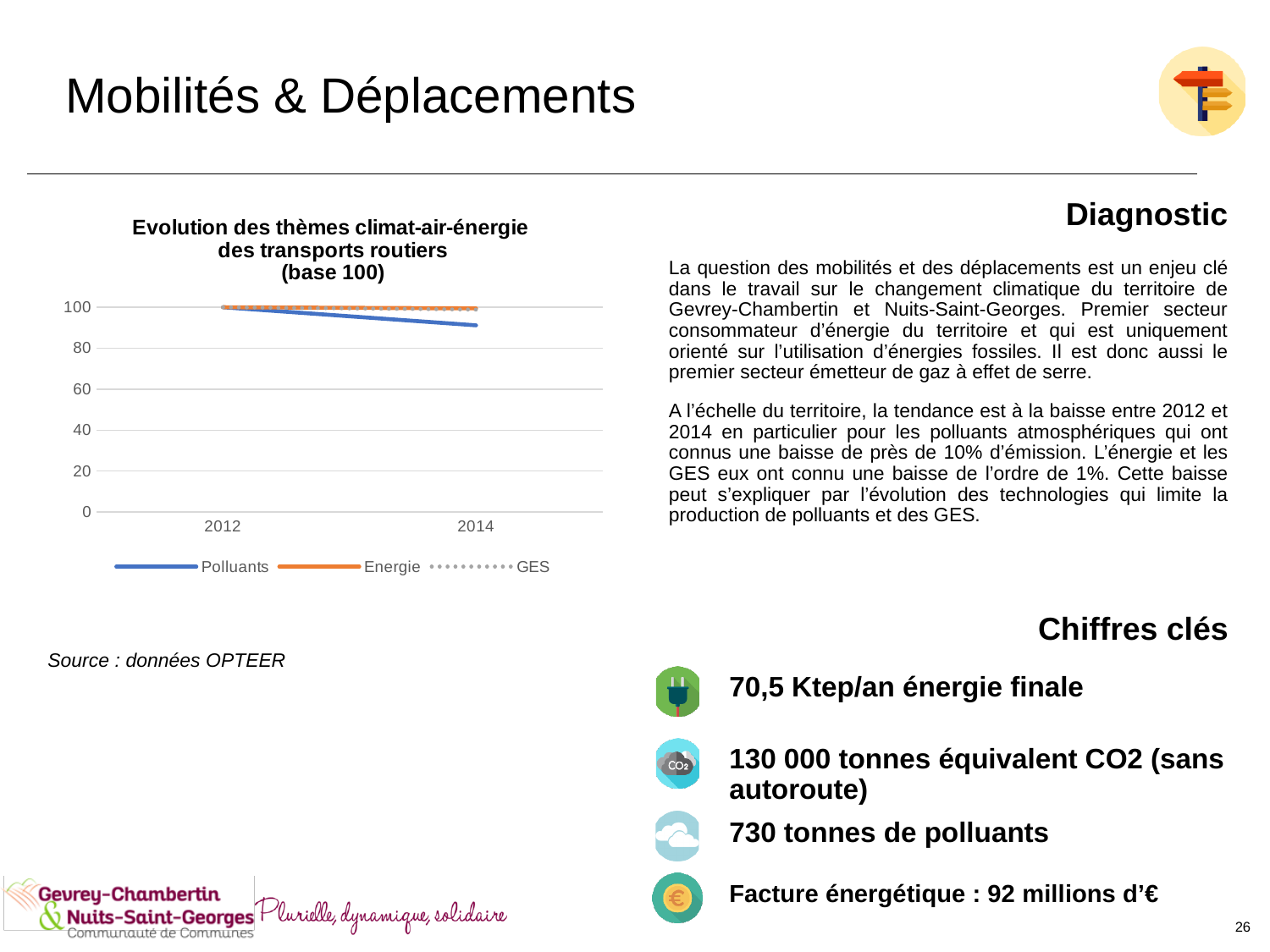
In 2014, which is larger, the value for Polluants or the value for Energie? Energie Is the value for Polluants in 2014 greater or less than 80? greater How many series does the legend of the chart list? 3 Which series is drawn with a dotted line? GES Does the Polluants line rise or fall from 2012 to 2014? fall What is the value for Polluants in 2012? 100 What kind of chart is shown on the slide? line chart What is the title of the chart? Evolution des thèmes climat-air-énergie des transports routiers (base 100) Is the value for Polluants in 2014 greater or less than 100? less Which series has the lowest value in 2014? Polluants How many years are shown on the x axis of the chart? 2